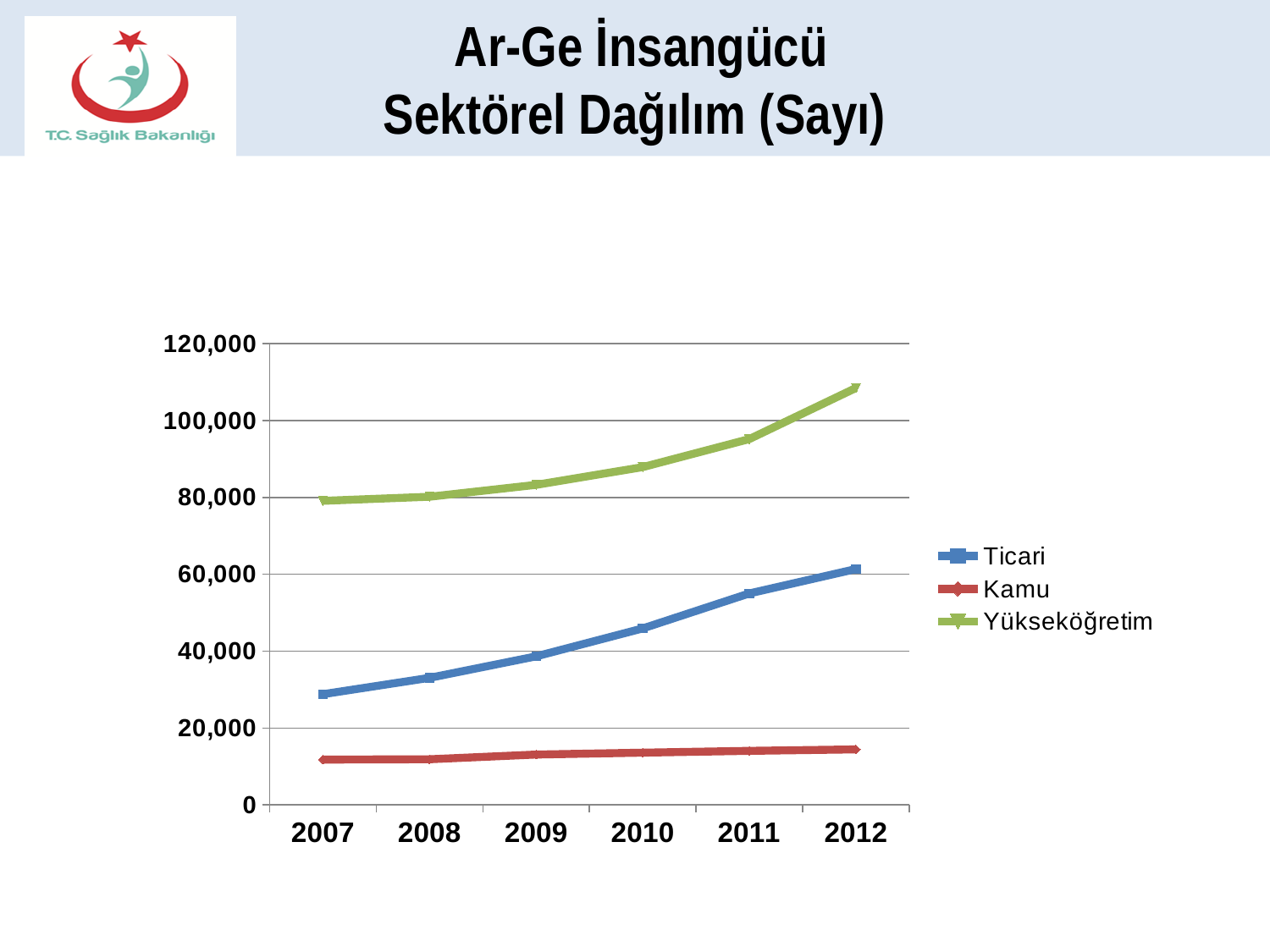
Is the value for Kamu in 2012 greater or less than 20,000? less Does the Ticari series rise or fall from 2007 to 2012? rise Is the value for Ticari in 2007 greater or less than 40,000? less Which is larger in 2010, the value for Ticari or the value for Kamu? Ticari Which series has the lowest values across all years? Kamu How many years are shown on the x axis? 6 What colour is the line for Kamu? red Is the value for Yükseköğretim in 2012 greater or less than 100,000? greater Which series has the highest values across all years? Yükseköğretim How many series does the legend list? 3 What kind of chart is shown on the slide? line chart